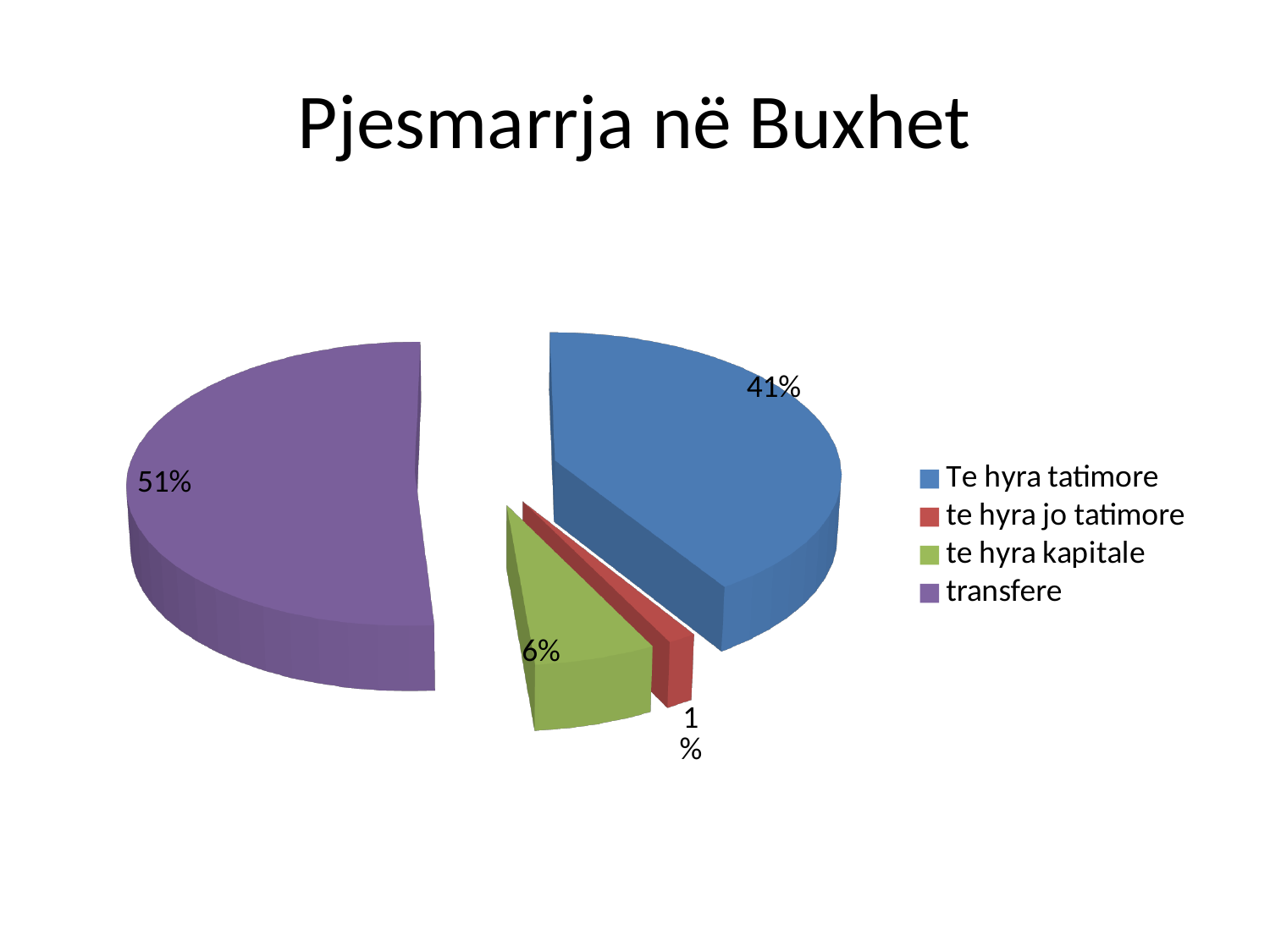
What is the difference in percentage points between 'transfere' and 'Te hyra tatimore'? 10 What share of the pie does 'te hyra jo tatimore' have? 1% What share of the pie does 'te hyra kapitale' have? 6% Which is larger, the share for 'te hyra kapitale' or the share for 'te hyra jo tatimore'? te hyra kapitale What share of the pie does 'transfere' have? 51% Which category has the largest share of the pie? transfere What is the title of the slide? Pjesmarrja në Buxhet How many categories does the pie chart have? 4 What kind of chart is shown on the slide? pie chart What colour is the slice for 'transfere'? purple Which category has the smallest share of the pie? te hyra jo tatimore